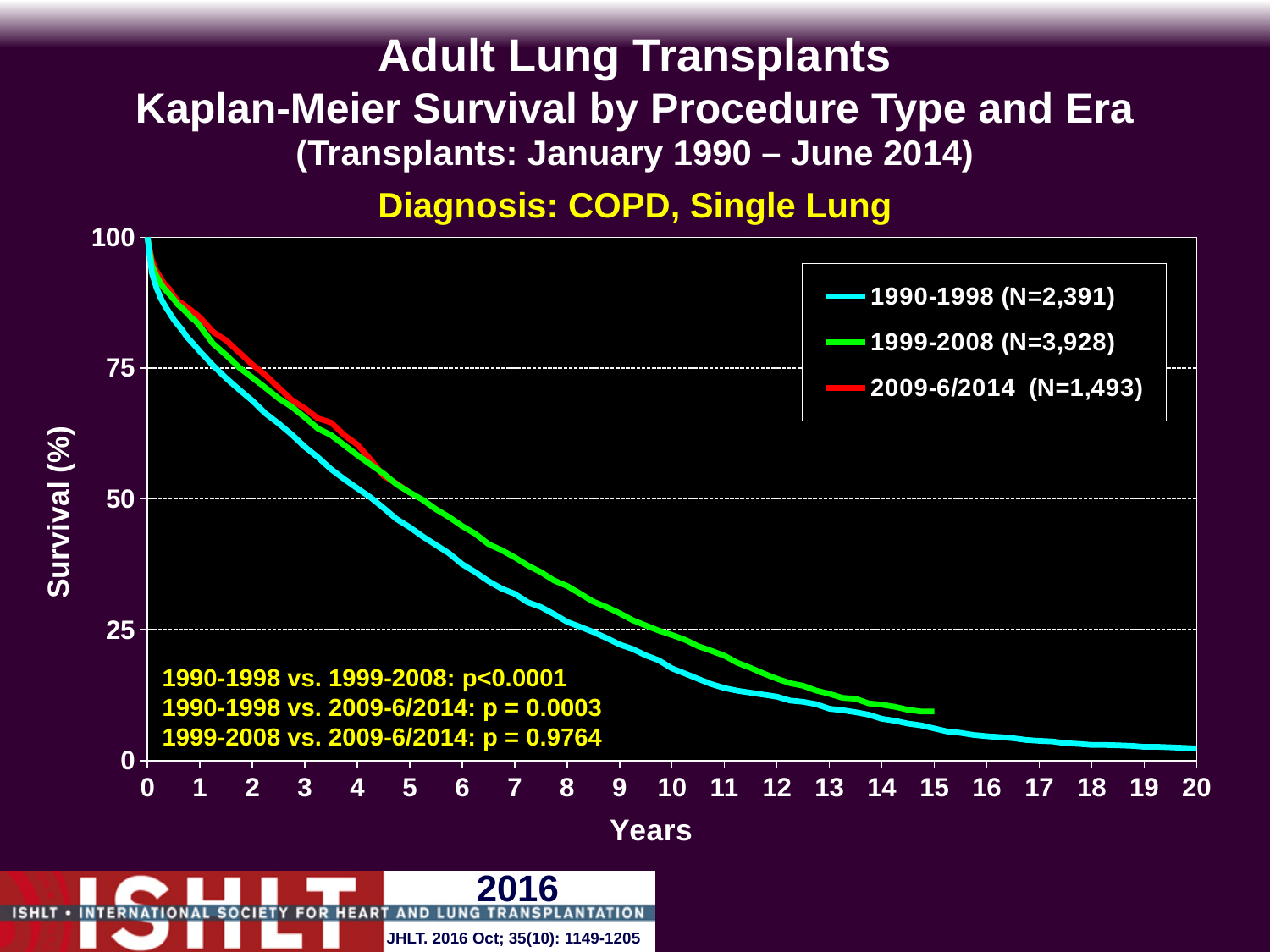
Is the survival value for the 1999-2008 era at year 3 greater or less than 75? less What is the label on the y axis? Survival (%) What kind of chart is shown on the slide? line chart Is the survival value for the 1990-1998 era at year 5 greater or less than 50? less Is the survival value for the 2009-6/2014 era at year 4 greater or less than 50? greater How many series does the legend list? 3 Do the survival curves rise or fall as years increase? fall Which era's curve extends furthest along the x axis? 1990-1998 What is the survival value for all three eras at year 0? 100 At year 8, which era has higher survival: 1990-1998 or 1999-2008? 1999-2008 What is the N shown in the legend for the 1999-2008 era? N=3,928